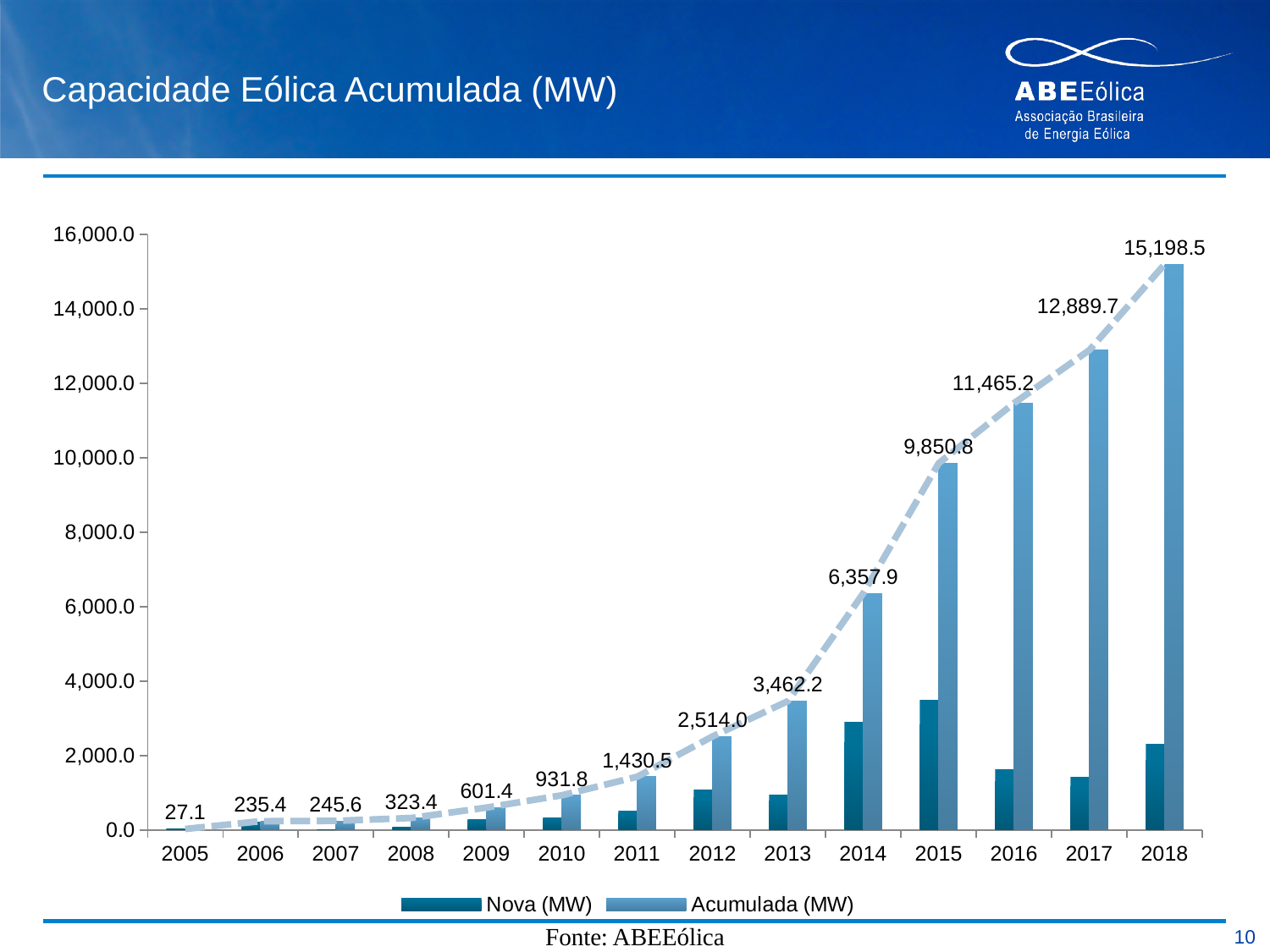
What is the difference between the Acumulada (MW) values for 2018 and 2017? 2,308.8 What is the Acumulada (MW) value for 2005? 27.1 How many series does the legend list? 2 Which is larger, the Acumulada (MW) value for 2014 or for 2013? 2014 Does the Acumulada (MW) series rise or fall from 2005 to 2018? rise Which year has the highest Acumulada (MW) value? 2018 Which year has the lowest Acumulada (MW) value? 2005 Is the Nova (MW) value for 2016 greater or less than 2,000.0? less Is the Nova (MW) value for 2015 greater or less than 2,000.0? greater What is the Acumulada (MW) value for 2018? 15,198.5 What is the Acumulada (MW) value for 2012? 2,514.0 How many years are shown on the x axis? 14